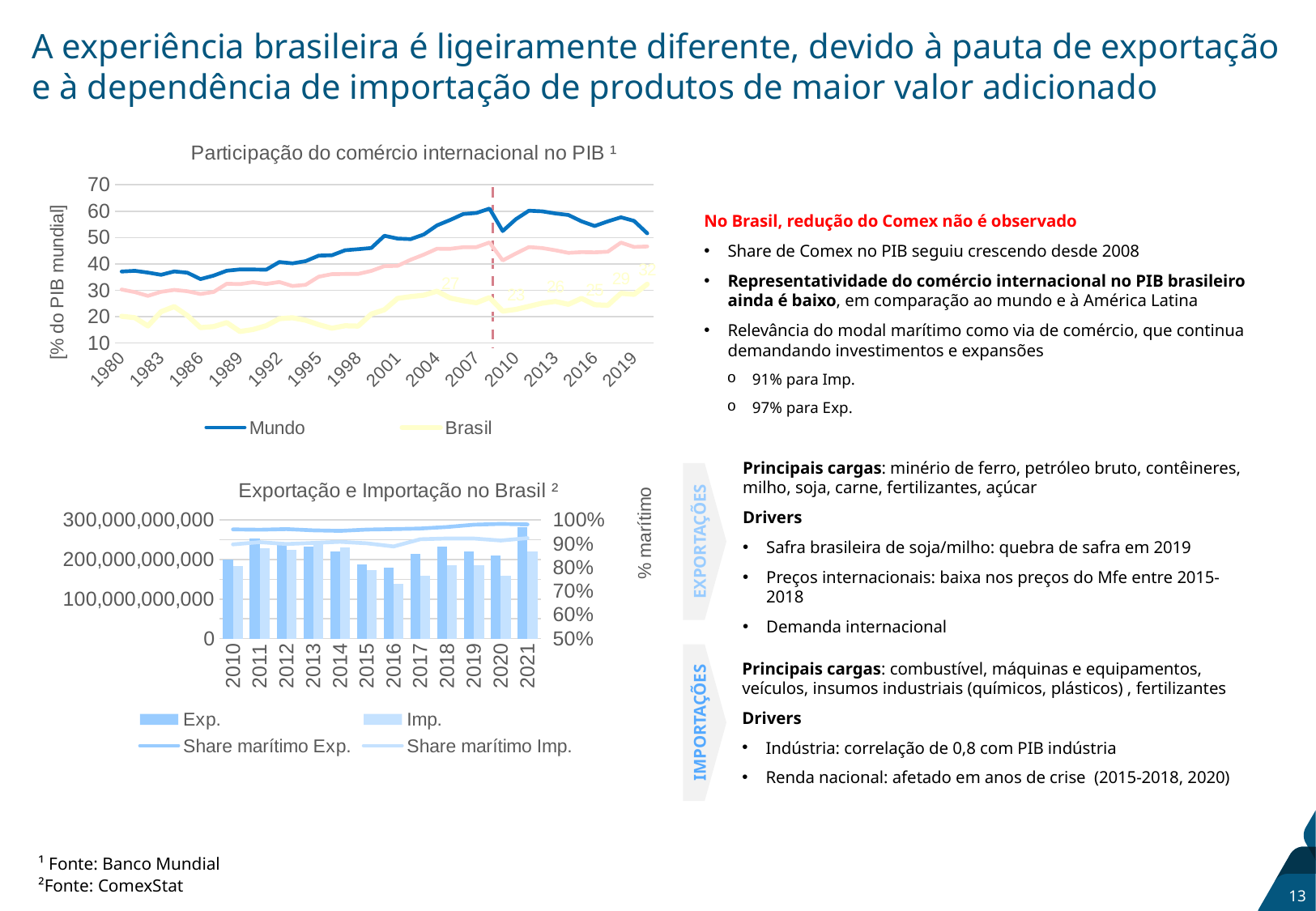
What kind of chart is 'Participação do comércio internacional no PIB'? Line chart In the 'Participação do comércio internacional no PIB' chart, is the Brasil value for 1990 greater or less than 20? less In the 'Exportação e Importação no Brasil' chart, is the Imp. value for 2016 greater or less than 200,000,000,000? less In the 'Participação do comércio internacional no PIB' chart, is the Mundo value for 1980 greater or less than 40? less In the 'Exportação e Importação no Brasil' chart, is the Exp. bar or the Imp. bar larger in 2016? Exp. In the 'Participação do comércio internacional no PIB' chart, does the Mundo line generally rise or fall between 1980 and 2008? Rise In the 'Exportação e Importação no Brasil' chart, which year has the lowest Imp. bar? 2016 How many years are shown on the x axis of the 'Exportação e Importação no Brasil' chart? 12 In the 'Exportação e Importação no Brasil' chart, which year has the highest Exp. bar? 2021 How many series does the legend of the 'Participação do comércio internacional no PIB' chart list? 2 How many series does the legend of the 'Exportação e Importação no Brasil' chart list? 4